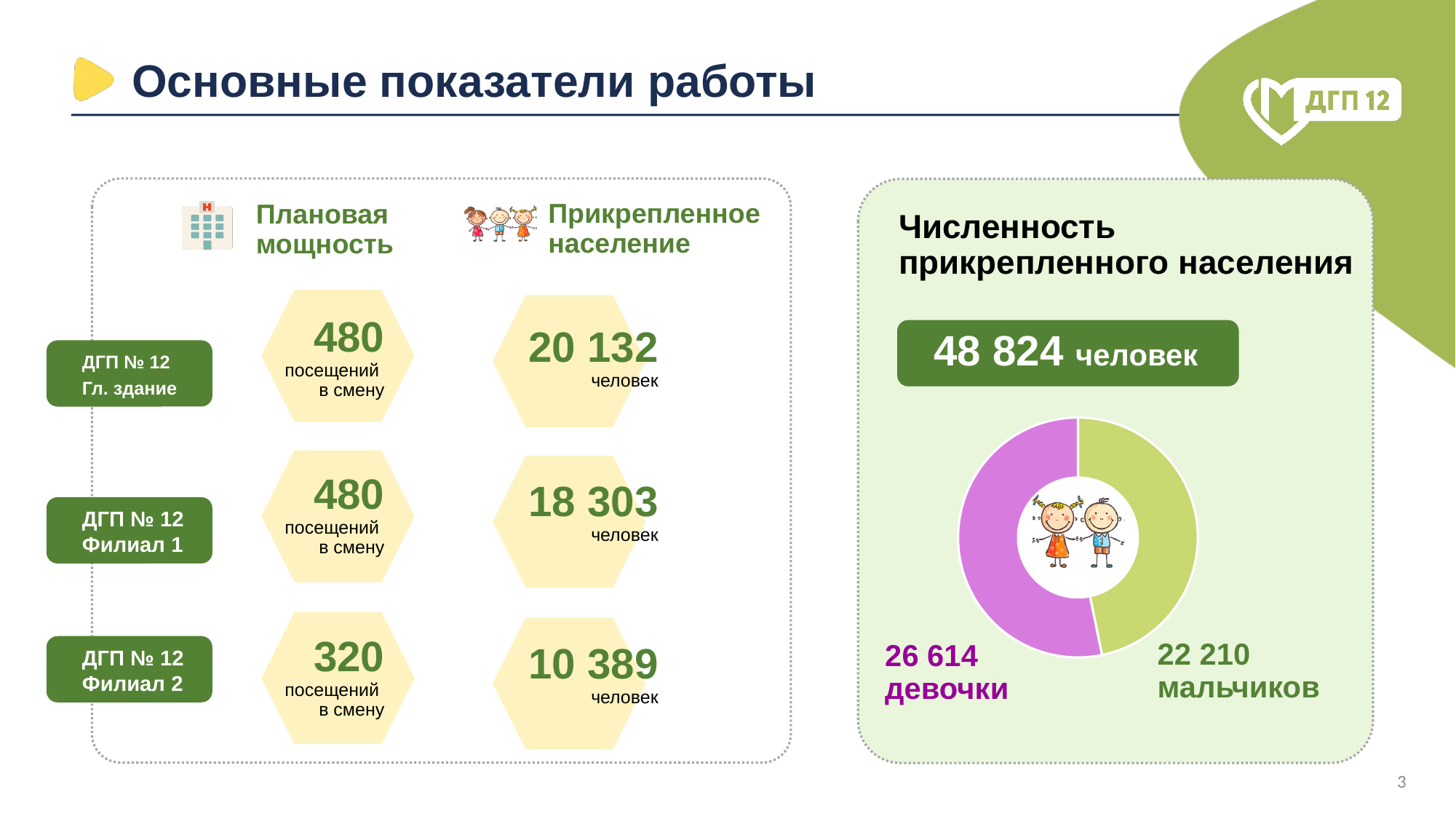
In the donut chart, how many boys (мальчиков) are in the attached population? 22 210 Which segment of the donut chart is the largest? Girls (девочки), 26 614 Which segment of the donut chart is the smallest? Boys (мальчиков), 22 210 In the donut chart, how many girls (девочки) are in the attached population? 26 614 What is the total attached population shown above the donut chart? 48 824 человек What share of the total attached population (48 824) do girls (26 614) make up in the donut chart? 54.5% What colour represents girls (девочки) in the donut chart? Purple (pink-violet) What kind of chart is shown under the heading "Численность прикрепленного населения"? Donut (pie) chart How many segments does the donut chart have? 2 What colour represents boys (мальчиков) in the donut chart? Green By how many people does the number of girls exceed the number of boys in the donut chart? 4 404 Which group is larger in the donut chart, girls or boys? Girls (девочки)